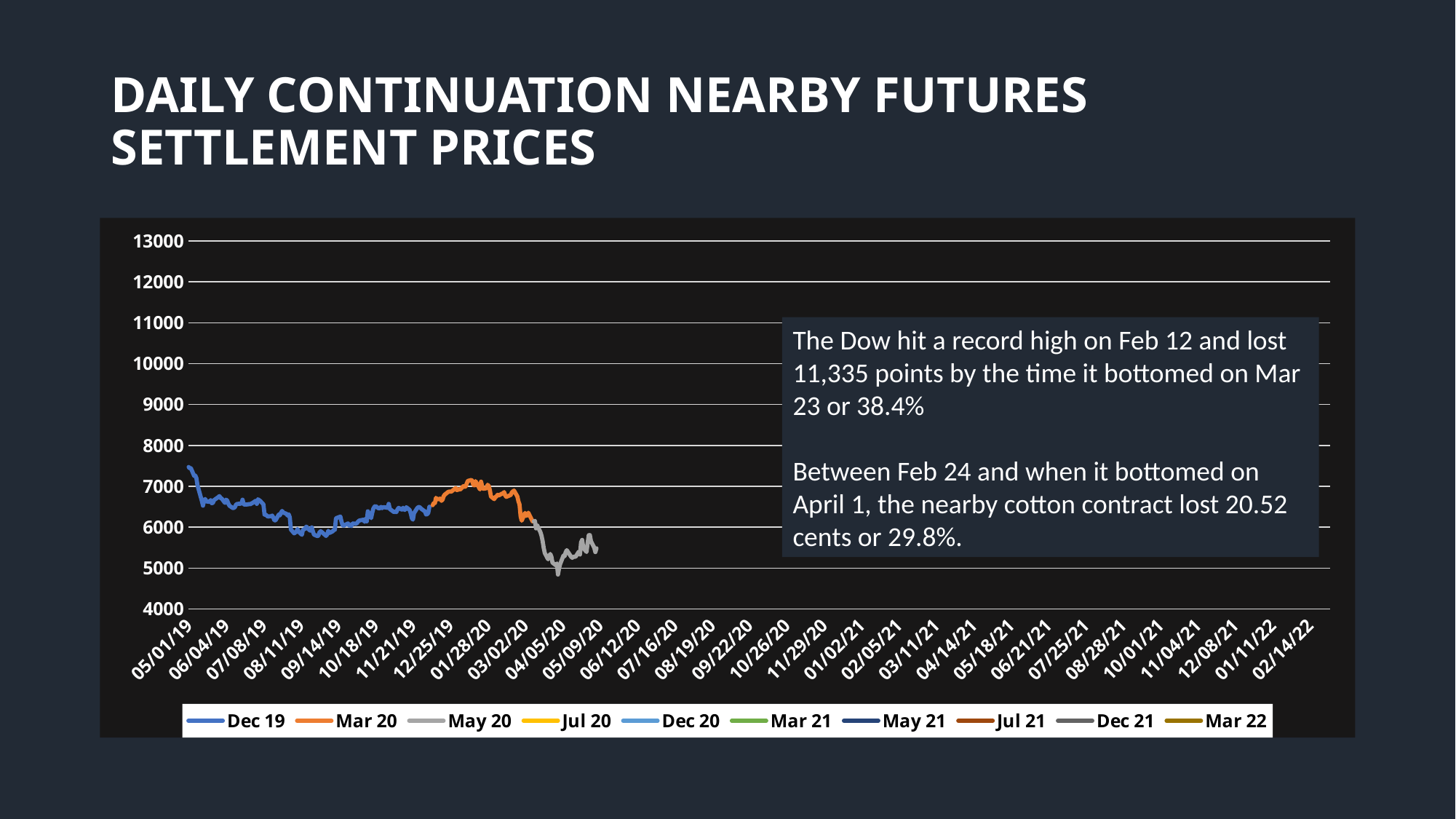
Is the first plotted value of the Dec 19 series greater or less than 7000? greater How many series does the legend list? 10 What is the highest value shown on the vertical axis? 13000 Is the lowest value of the May 20 series greater or less than 6000? less What kind of chart is shown on the slide? line chart What is the title of the slide containing the chart? DAILY CONTINUATION NEARBY FUTURES SETTLEMENT PRICES Do the values of the May 20 series generally rise or fall from its start to its lowest point? fall How many of the legend series actually have data plotted on the chart? 3 Is the highest value of the Mar 20 series greater or less than 8000? less Which series reaches the lowest value on the chart? May 20 What colour is the Mar 20 series line in the chart? orange Which series reaches a higher peak value, Mar 20 or May 20? Mar 20